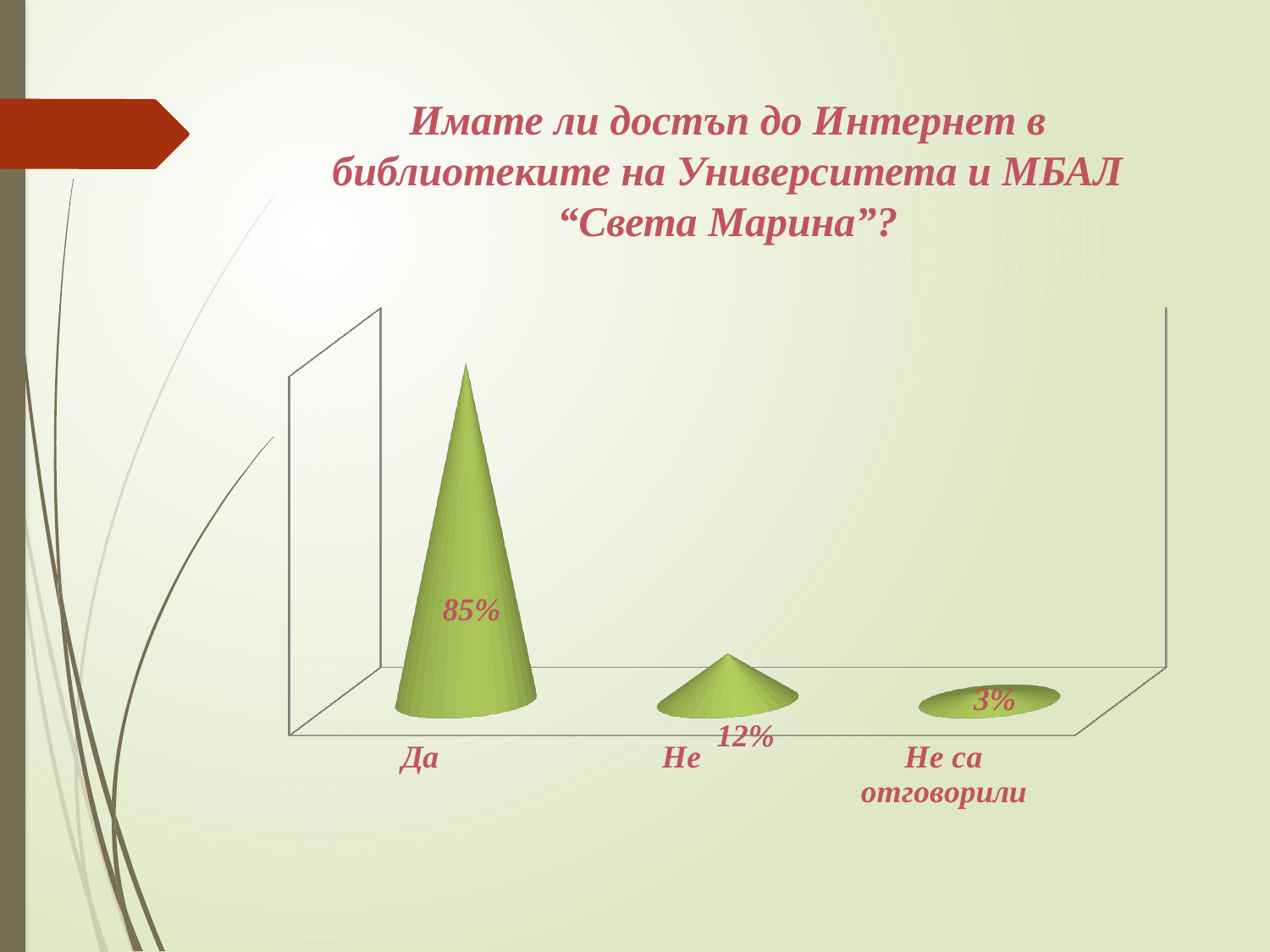
Which is larger, the value for "Не" or the value for "Не са отговорили"? Не What is the value for "Не"? 12% Which category has the highest value? Да What is the value for "Не са отговорили"? 3% How many categories are shown in the chart? 3 Do the values rise or fall from left to right across the categories? fall What is the value for "Да"? 85% What is the title of the slide above the chart? Имате ли достъп до Интернет в библиотеките на Университета и МБАЛ "Света Марина"? What kind of chart is shown on the slide? bar chart What is the difference between the values for "Не" and "Не са отговорили"? 9% What is the difference between the values for "Да" and "Не"? 73% Which category has the lowest value? Не са отговорили